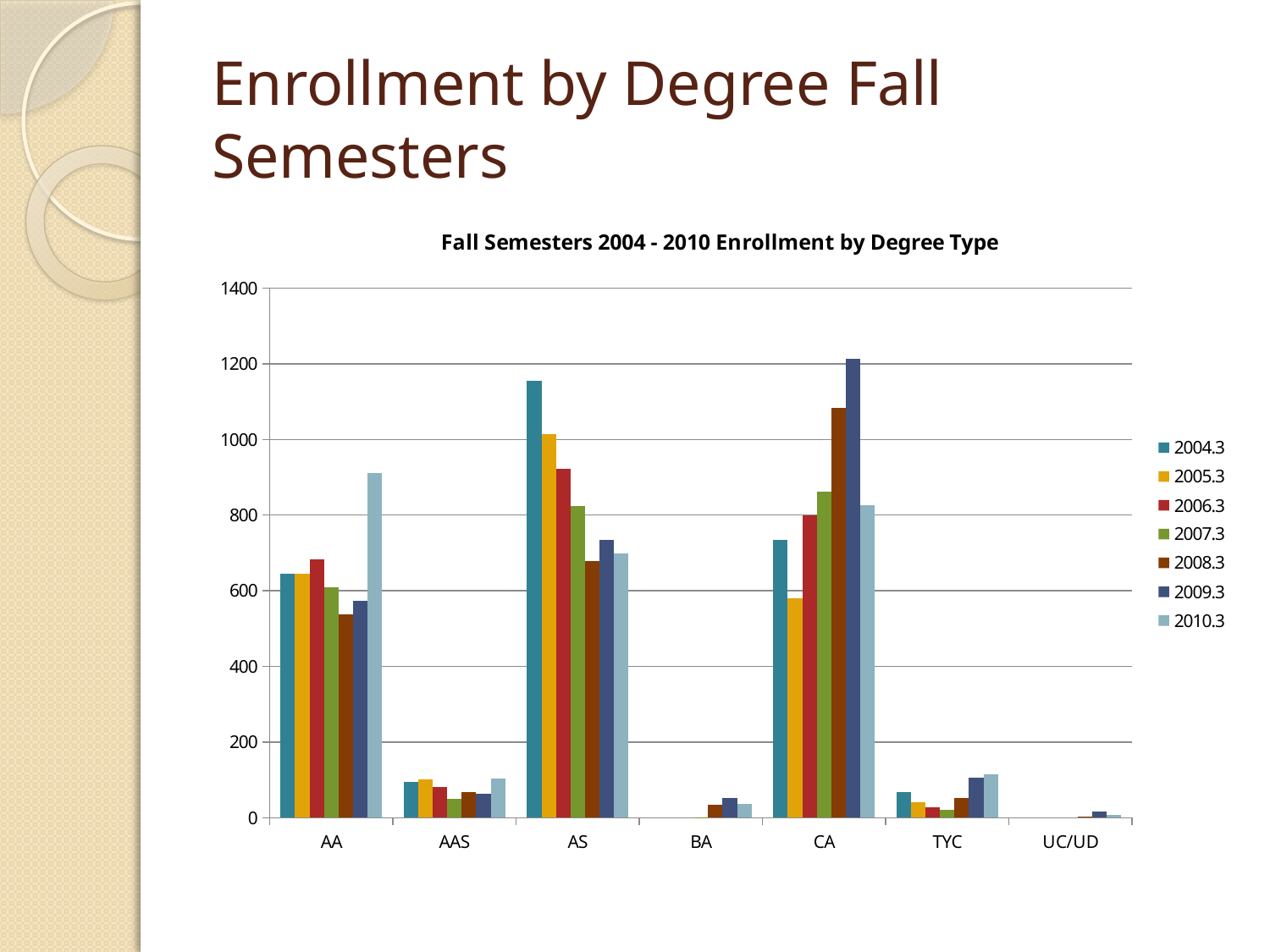
For the AS degree type, do the values rise or fall from 2004.3 to 2008.3? fall What kind of chart is shown on the slide? bar chart Which degree type has the highest enrollment for the 2004.3 series? AS How many degree-type categories are shown on the x axis? 7 Is the value for AS in the 2004.3 series greater or less than 1000? greater Which degree type has the highest enrollment for the 2009.3 series? CA Is the value for AA in the 2010.3 series greater or less than 800? greater What is the title of the chart? Fall Semesters 2004 - 2010 Enrollment by Degree Type How many series does the legend list? 7 Is the value for AAS in the 2007.3 series greater or less than 100? less Which degree type has the lowest enrollment for the 2009.3 series? UC/UD For the AA degree type, which is larger: the 2010.3 value or the 2004.3 value? 2010.3